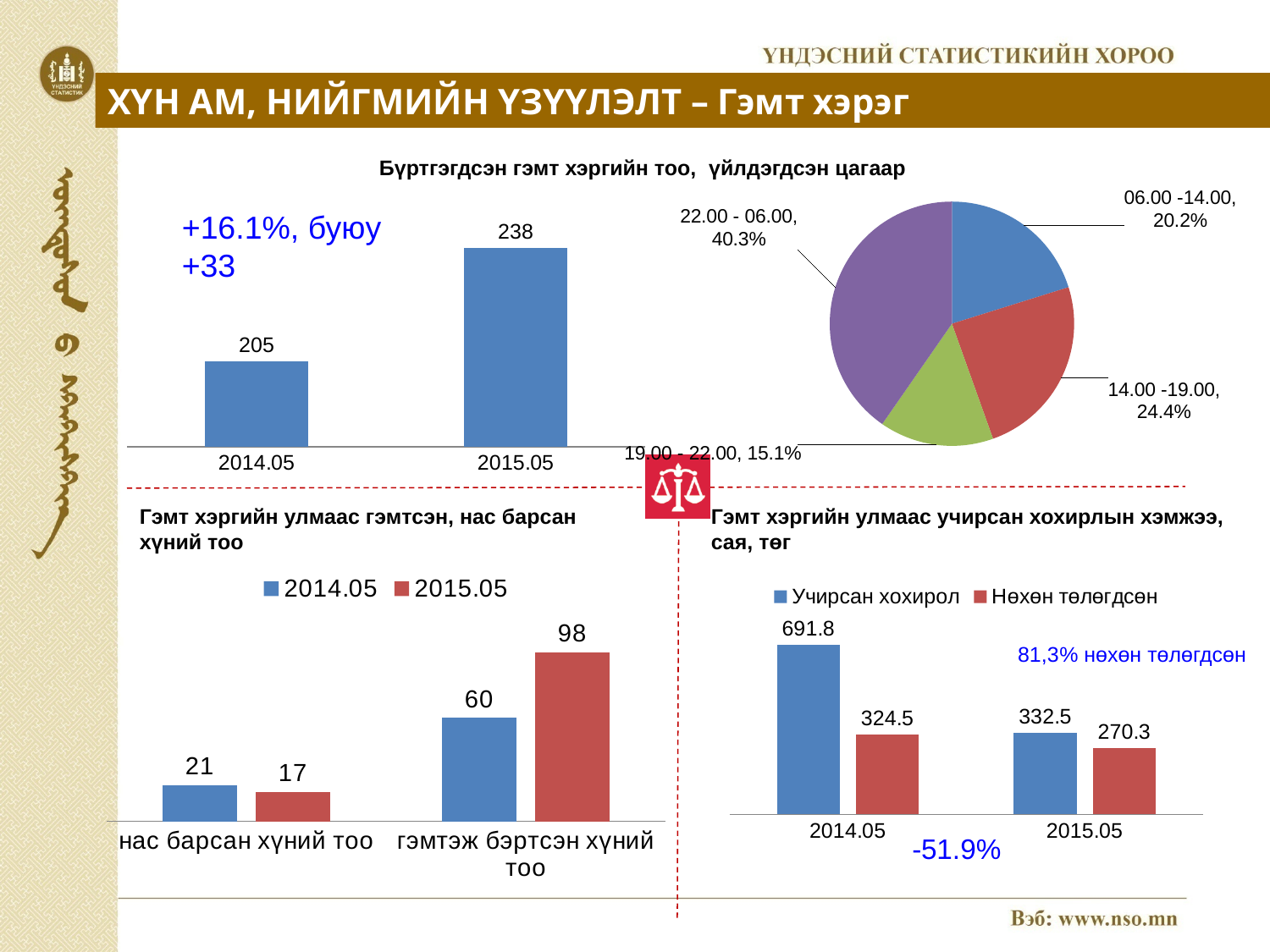
How many slices does the top-right pie chart (үйлдэгдсэн цагаар) have? 4 In the top-right pie chart (үйлдэгдсэн цагаар), which time period has the smallest share? 19.00 - 22.00 In the bottom-left bar chart (Гэмт хэргийн улмаас гэмтсэн, нас барсан хүний тоо), what is the 2015.05 value for гэмтэж бэртсэн хүний тоо? 98 How many series does the legend of the bottom-left bar chart (Гэмт хэргийн улмаас гэмтсэн, нас барсан хүний тоо) list? 2 In the top-left bar chart (Бүртгэгдсэн гэмт хэргийн тоо), what is the difference between the 2015.05 and 2014.05 values? 33 In the top-right pie chart (үйлдэгдсэн цагаар), which time period has the largest share? 22.00 - 06.00 In the bottom-left bar chart (Гэмт хэргийн улмаас гэмтсэн, нас барсан хүний тоо), which is larger for нас барсан хүний тоо: 2014.05 or 2015.05? 2014.05 In the bottom-right bar chart (Гэмт хэргийн улмаас учирсан хохирлын хэмжээ, сая, төг), what is the difference between Учирсан хохирол and Нөхөн төлөгдсөн for 2015.05? 62.2 In the top-right pie chart (үйлдэгдсэн цагаар), what share does the 14.00 -19.00 slice have? 24.4% What kind of chart is the bottom-right chart (Гэмт хэргийн улмаас учирсан хохирлын хэмжээ, сая, төг)? bar chart In the bottom-right bar chart (Гэмт хэргийн улмаас учирсан хохирлын хэмжээ, сая, төг), what is the Учирсан хохирол value for 2014.05? 691.8 In the top-left bar chart (Бүртгэгдсэн гэмт хэргийн тоо), what is the value for 2015.05? 238